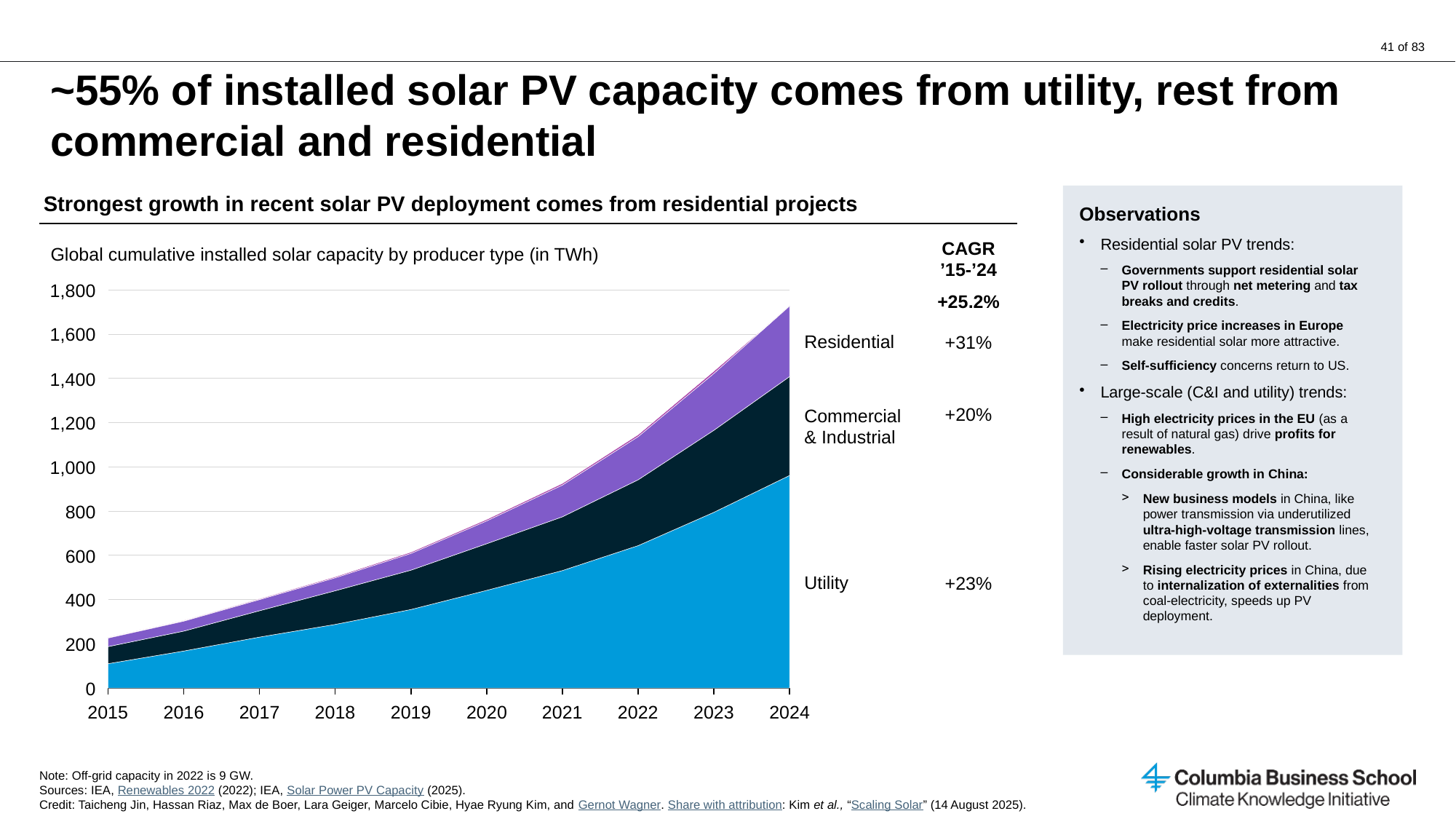
Does the total cumulative installed solar capacity rise or fall from 2015 to 2024? Rise Is the Utility capacity in 2024 greater or less than 1,000? less Which producer type has the highest CAGR '15-'24? Residential Which producer type has the lowest CAGR '15-'24? Commercial & Industrial How many years are shown on the x axis? 10 What is the CAGR '15-'24 shown for Commercial & Industrial? +20% What is the overall CAGR '15-'24 shown at the top of the CAGR column? +25.2% Is the total cumulative installed solar capacity in 2024 greater or less than 1,600? greater What unit is the cumulative installed solar capacity measured in, according to the chart subtitle? TWh What is the CAGR '15-'24 shown for Utility? +23% What kind of chart is shown on the slide? Stacked area chart What is the CAGR '15-'24 shown for Residential? +31%